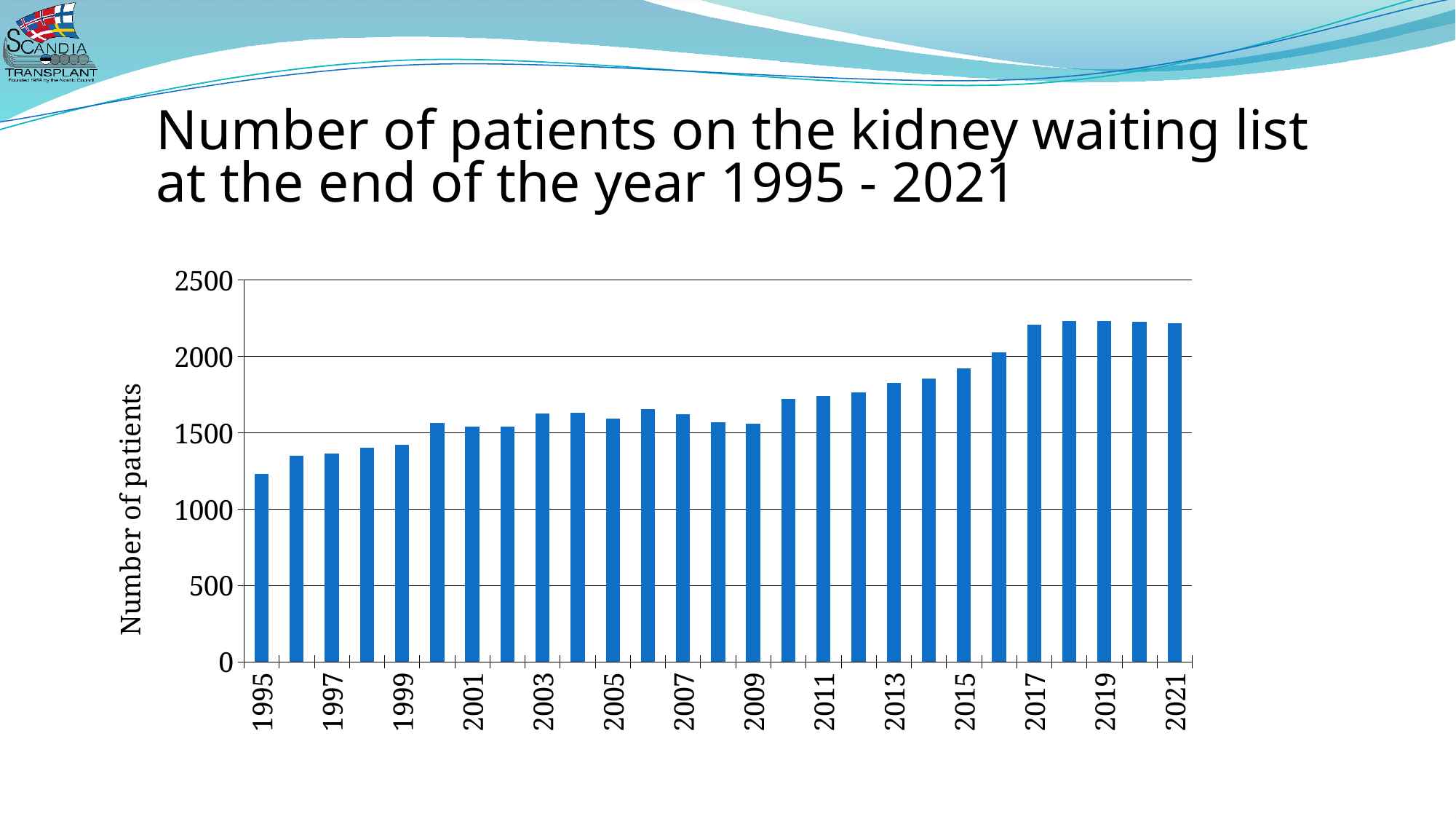
Overall, do the values rise or fall from 1995 to 2021? rise What kind of chart is shown on the slide? bar chart Is the value for 2021 greater or less than 2000? greater Is the value for 1995 greater or less than 1500? less Is the value for 1999 greater or less than 1500? less What is the label on the vertical axis of the chart? Number of patients How many years (bars) are plotted in the chart? 27 Which year has the lowest number of patients on the kidney waiting list? 1995 Which year has the larger number of patients, 2013 or 2007? 2013